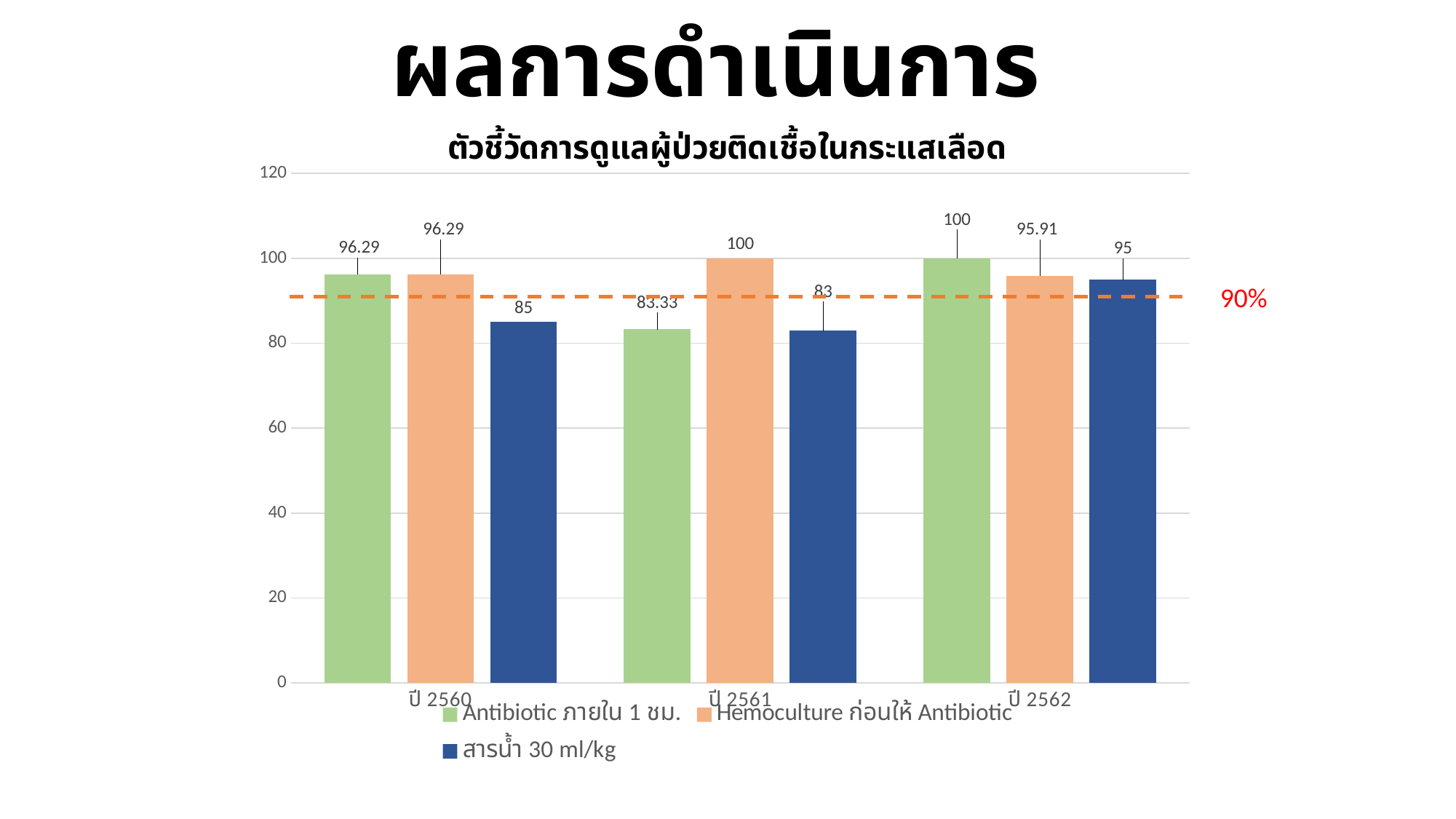
What is the difference between the Hemoculture ก่อนให้ Antibiotic value in ปี 2561 and in ปี 2562? 4.09 What is the value for Antibiotic ภายใน 1 ชม. in ปี 2560? 96.29 Which is larger in ปี 2561: the value for Antibiotic ภายใน 1 ชม. or the value for Hemoculture ก่อนให้ Antibiotic? Hemoculture ก่อนให้ Antibiotic What is the value for สารน้ำ 30 ml/kg in ปี 2562? 95 In which year is the value for สารน้ำ 30 ml/kg the lowest? ปี 2561 What kind of chart is shown on the slide? bar chart In which year is the value for Antibiotic ภายใน 1 ชม. the highest? ปี 2562 How many series does the legend list? 3 Is the value for สารน้ำ 30 ml/kg in ปี 2560 greater or less than 90? less What is the value for Antibiotic ภายใน 1 ชม. in ปี 2561? 83.33 What is the value for Hemoculture ก่อนให้ Antibiotic in ปี 2561? 100 What percentage does the red dashed reference line on the chart mark? 90%